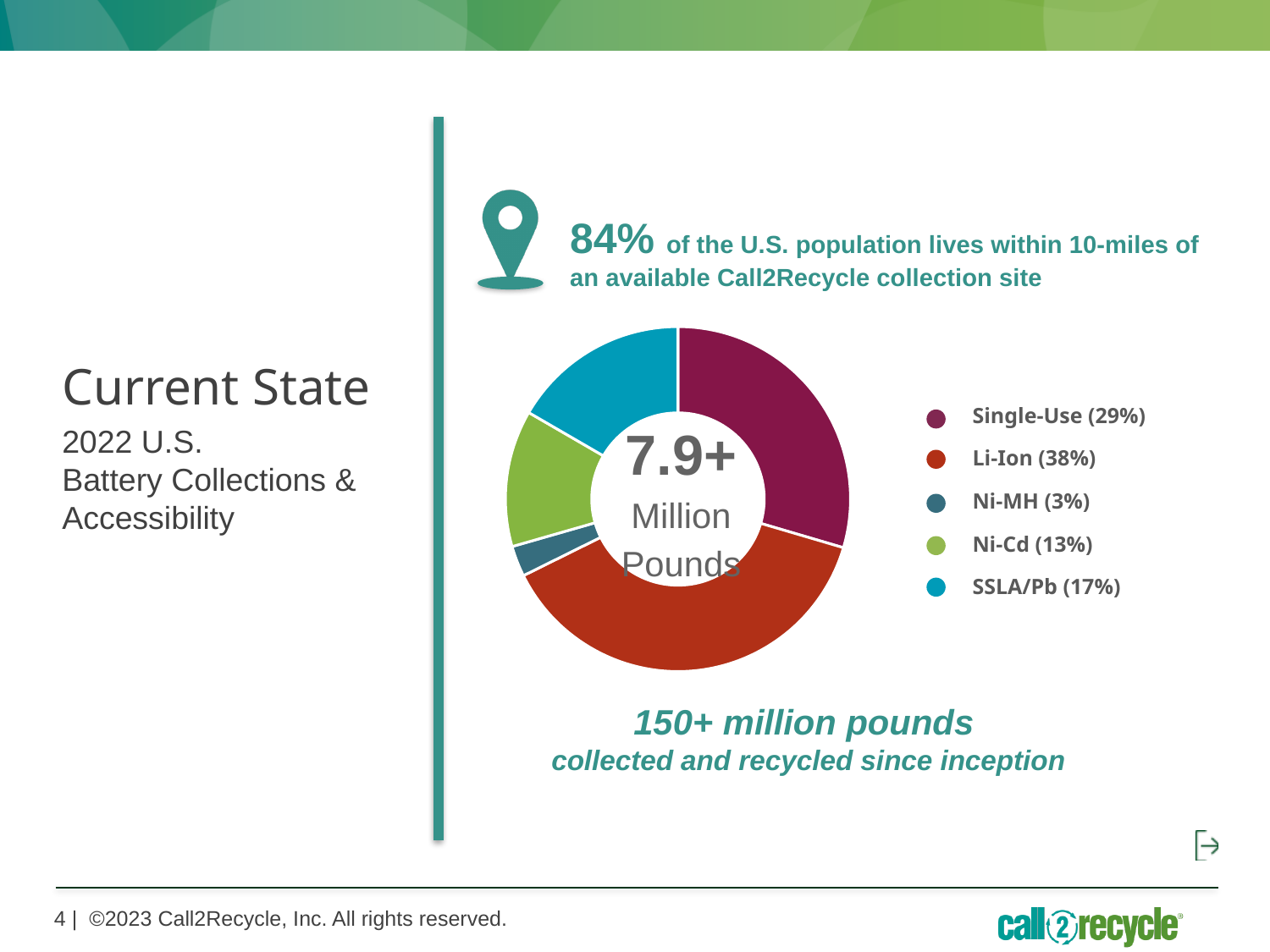
What is the difference in percentage points between the Li-Ion and Single-Use shares? 9 Which colour represents Li-Ion in the donut chart? Red What percentage is shown for Ni-Cd in the chart legend? 13% What share of the donut chart does Li-Ion represent? 38% What text appears in the center of the donut chart? 7.9+ Million Pounds How many battery categories are shown in the donut chart? 5 What percentage is shown for Single-Use in the chart legend? 29% Which has a larger share, Ni-Cd or SSLA/Pb? SSLA/Pb What kind of chart is shown on the slide? Donut (pie) chart Which battery category has the smallest share in the donut chart? Ni-MH Which battery category has the largest share in the donut chart? Li-Ion What is the combined share of Ni-MH and SSLA/Pb? 20%